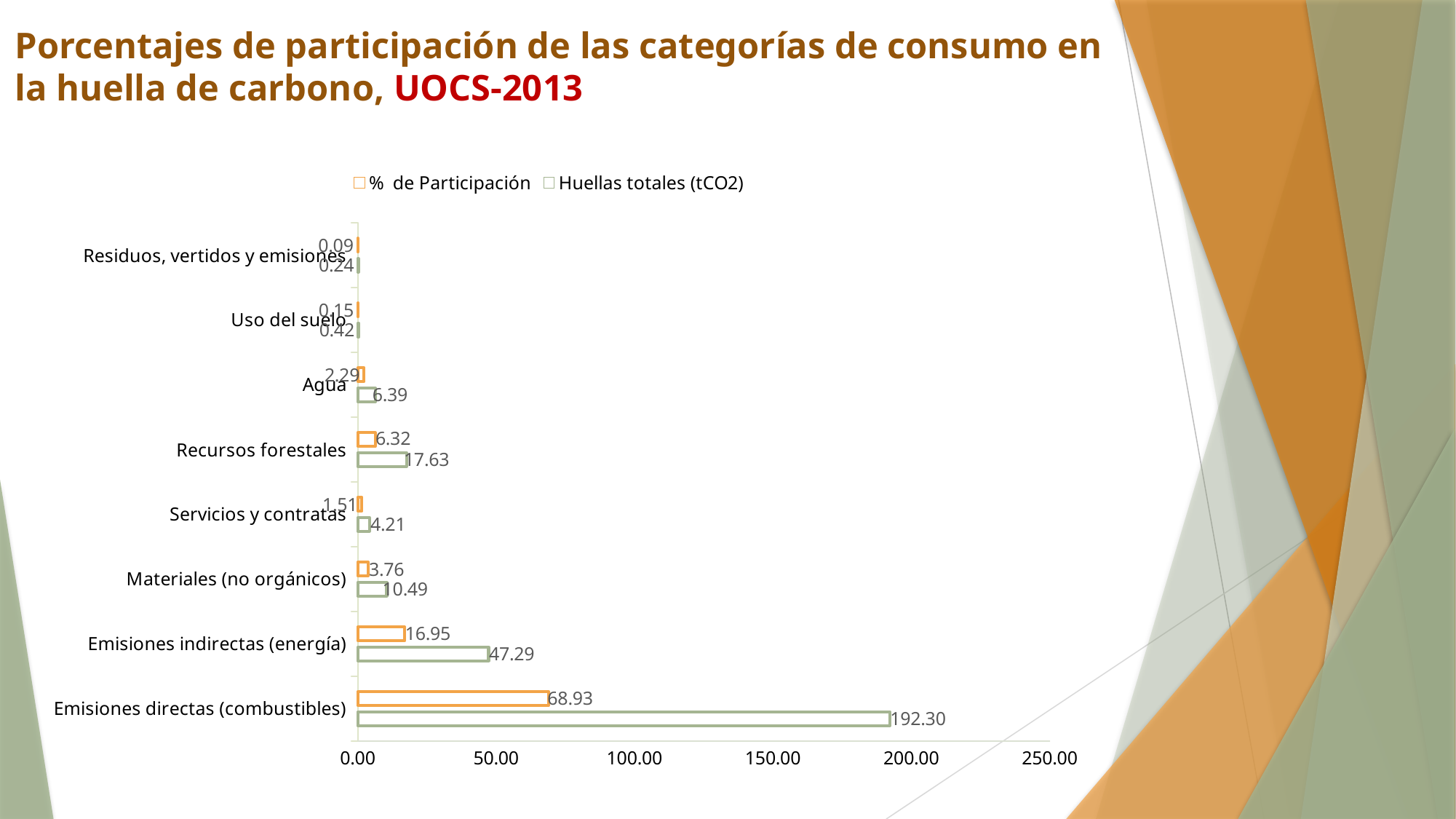
How many series does the legend list? 2 Which category has the lowest Huellas totales (tCO2)? Residuos, vertidos y emisiones What are the two series names listed in the legend? % de Participación and Huellas totales (tCO2) Is the Huellas totales (tCO2) value for Emisiones indirectas (energía) greater or less than 50.00? less Which has a larger % de Participación, Recursos forestales or Materiales (no orgánicos)? Recursos forestales What is the Huellas totales (tCO2) value for Emisiones directas (combustibles)? 192.30 What is the Huellas totales (tCO2) value for Recursos forestales? 17.63 How many categories are shown on the chart? 8 Which category has the highest % de Participación? Emisiones directas (combustibles) What is the difference between the Huellas totales (tCO2) values for Emisiones directas (combustibles) and Emisiones indirectas (energía)? 145.01 What is the % de Participación value for Emisiones indirectas (energía)? 16.95 What type of chart is shown on the slide? Bar chart